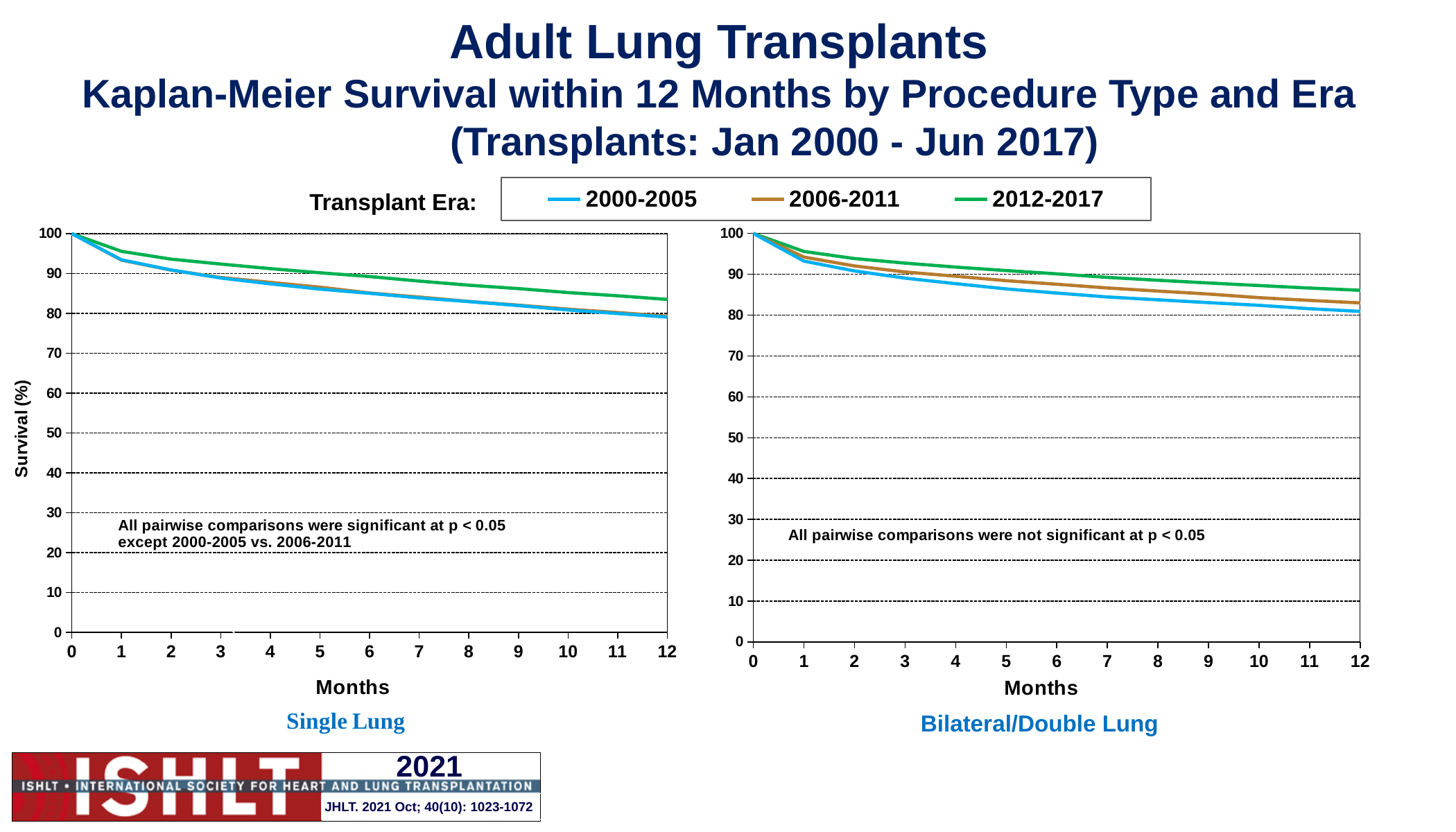
In the Bilateral/Double Lung chart, does survival rise or fall as months increase? fall In the Single Lung chart, is the survival for 2000-2005 at 6 months greater or less than 80? greater In the Single Lung chart, is the survival for 2012-2017 at 12 months greater or less than 80? greater In the Bilateral/Double Lung chart, is the survival for 2000-2005 at 6 months greater or less than 80? greater What is the label of the x axis on both charts? Months What kind of chart is the Single Lung chart? line chart In the Bilateral/Double Lung chart, which transplant era has the lowest survival at 12 months? 2000-2005 How many transplant eras does the legend list? 3 In the Bilateral/Double Lung chart, which transplant era has the highest survival at 12 months? 2012-2017 In the Single Lung chart, which transplant era has the highest survival at 12 months? 2012-2017 In the Single Lung chart, what is the survival (%) for all eras at month 0? 100